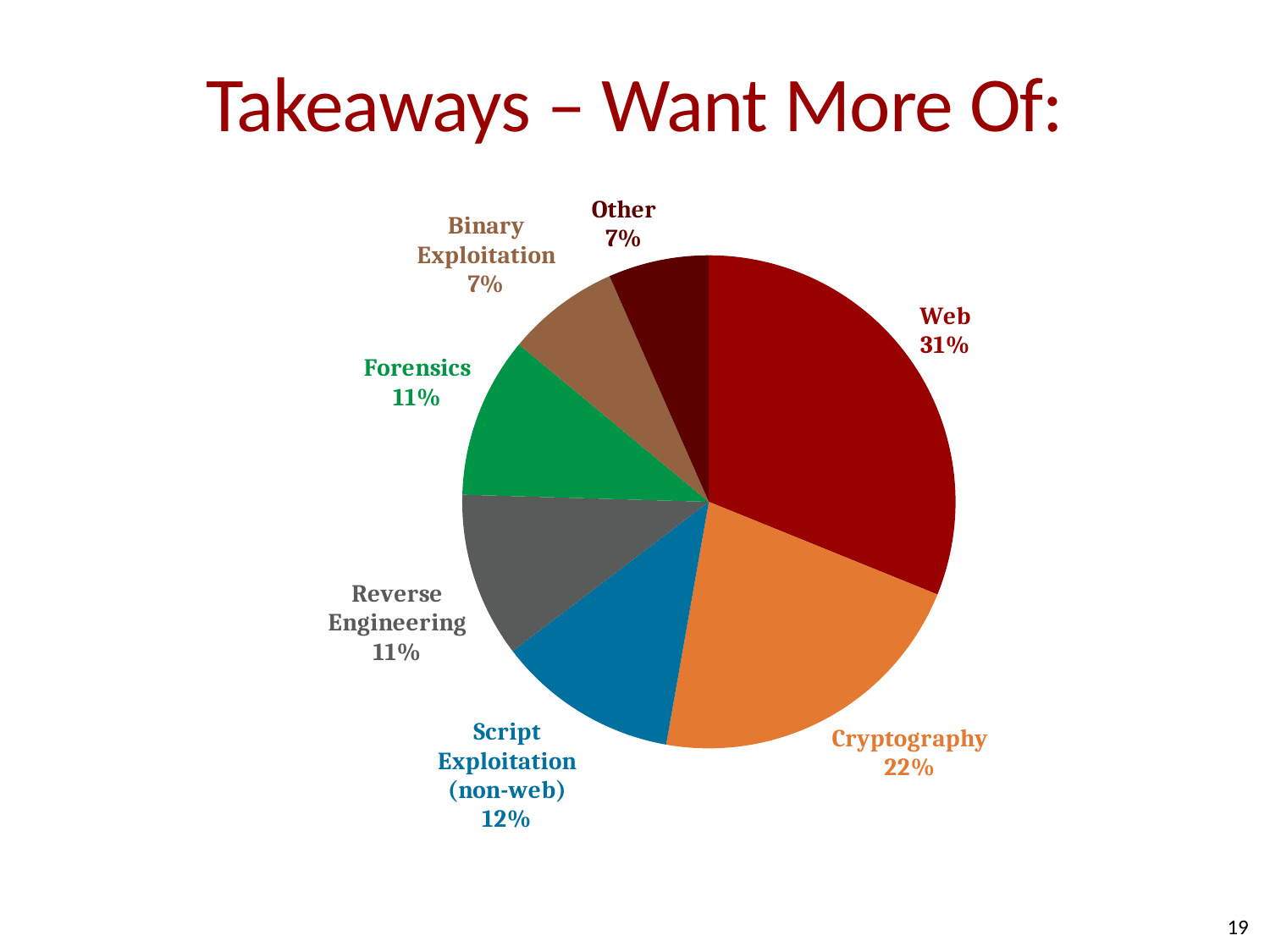
How many slices does the pie chart have? 7 What share of the pie does Cryptography have? 22% What is the difference between the Web share and the Cryptography share? 9% What share of the pie does Forensics have? 11% What kind of chart is shown on the slide? pie chart What is the difference between the Forensics share and the Other share? 4% What share of the pie does Binary Exploitation have? 7% What is the title of the slide containing the pie chart? Takeaways – Want More Of: Which is larger, the share for Script Exploitation (non-web) or the share for Reverse Engineering? Script Exploitation (non-web) Which category has the largest slice of the pie? Web